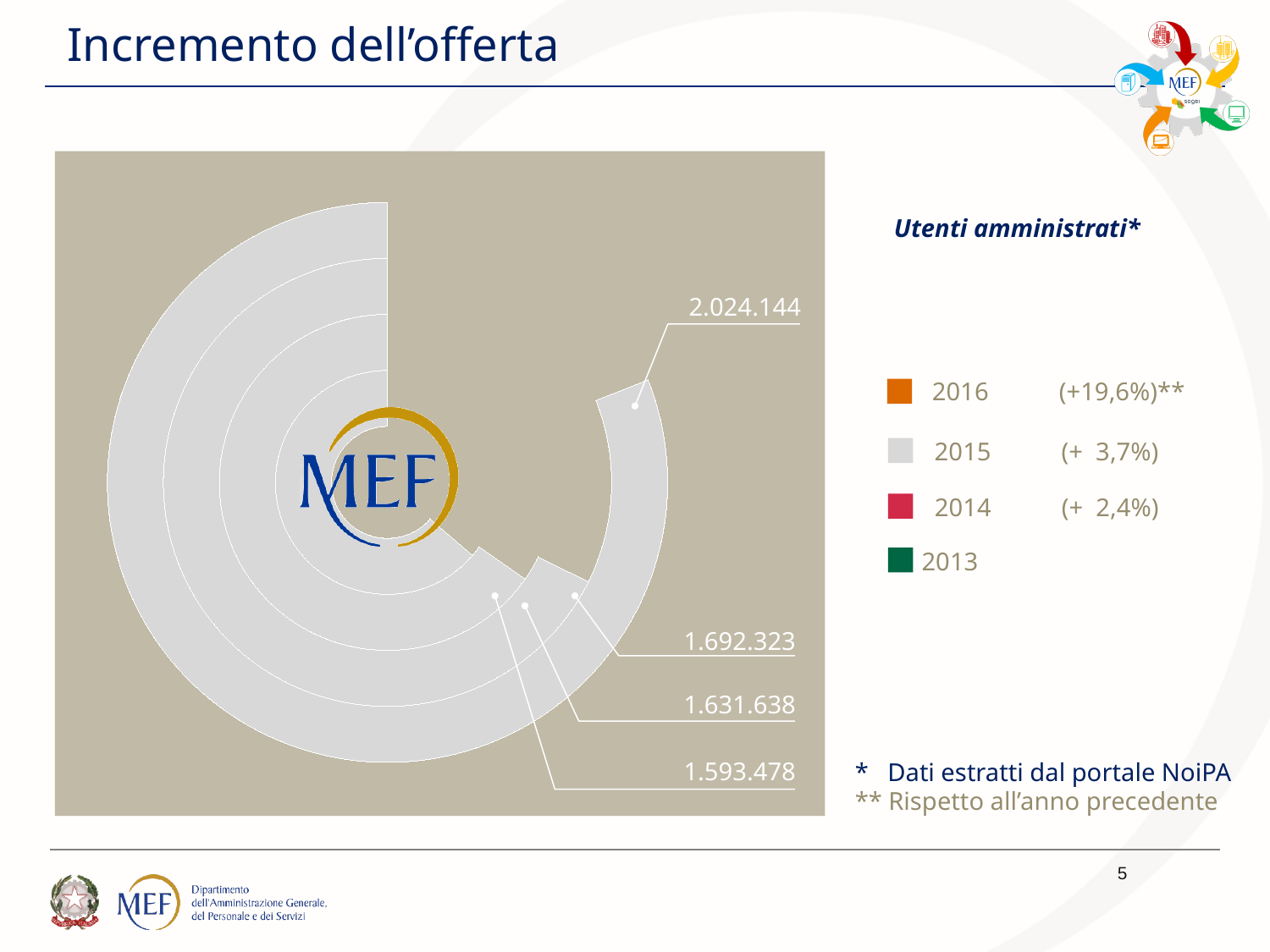
What is the title of the chart? Utenti amministrati* What is the difference between 1.631.638 and 1.593.478? 38.160 How many data values are plotted on the chart? 4 How many entries does the legend list? 4 What is the difference between the highest value (2.024.144) and the second highest value (1.692.323)? 331.821 What is the difference between 1.692.323 and 1.631.638? 60.685 Which is larger, 1.692.323 or 2.024.144? 2.024.144 What is the lowest value shown on the chart? 1.593.478 What percentage increase does the legend show for 2016? (+19,6%)** What is the value for the innermost arc (2013)? 1.593.478 What is the highest value shown on the chart? 2.024.144 What is the value for the outermost arc (2016)? 2.024.144